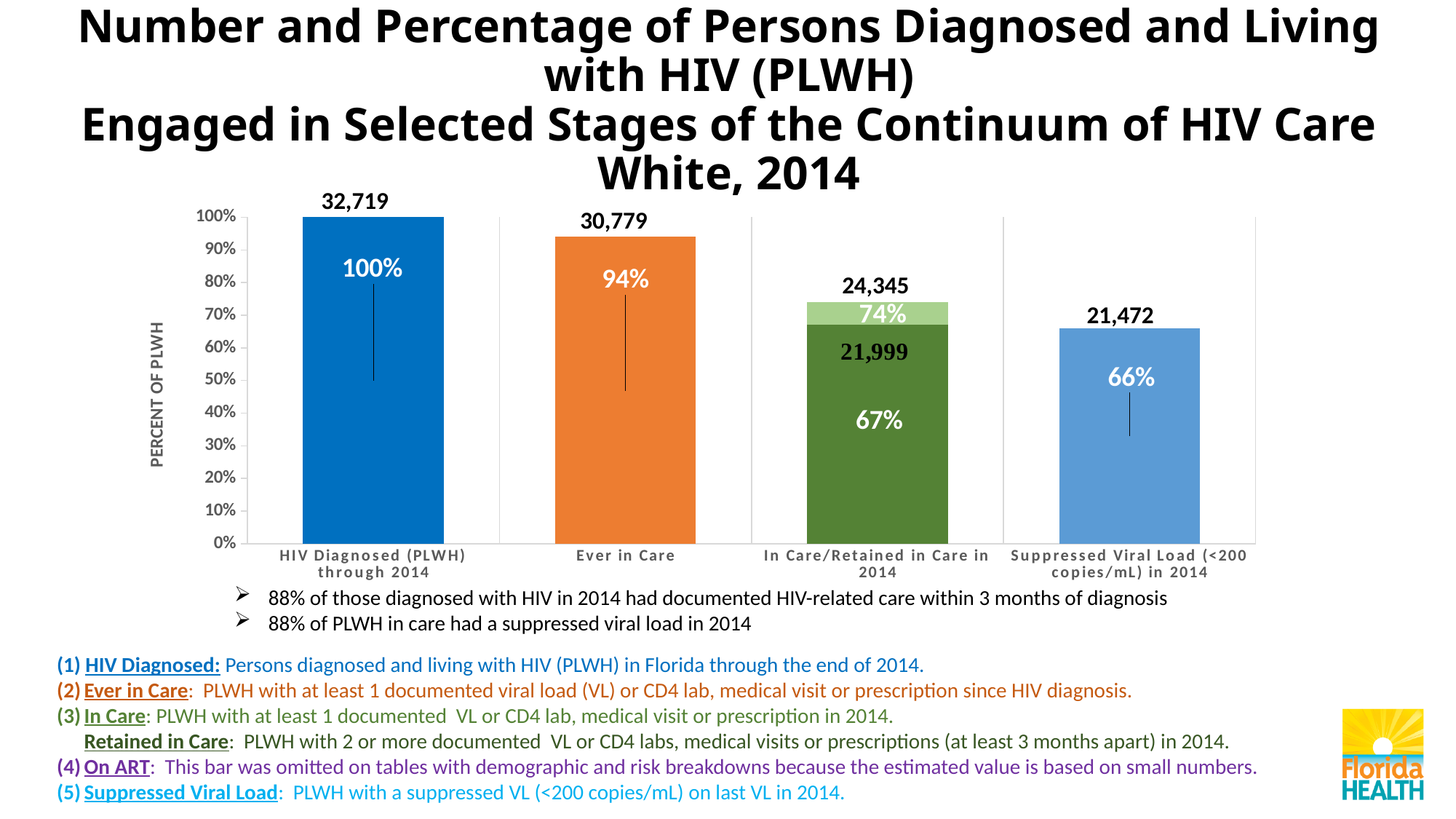
What kind of chart is shown on the slide? Bar chart Which category has the highest percentage of PLWH? HIV Diagnosed (PLWH) through 2014 What number is printed above the Ever in Care bar? 30,779 What number is printed above the bar for HIV Diagnosed (PLWH) through 2014? 32,719 Which category has the lowest percentage of PLWH? Suppressed Viral Load (<200 copies/mL) in 2014 How many categories are shown on the x axis of the chart? 4 What number is printed above the In Care/Retained in Care in 2014 bar? 24,345 What percentage is shown for the darker green Retained in Care portion of the In Care/Retained in Care in 2014 bar? 67% What percentage is shown on the Suppressed Viral Load (<200 copies/mL) in 2014 bar? 66% What percentage is shown on the Ever in Care bar? 94% Which is larger, the percentage for Ever in Care or the percentage for Suppressed Viral Load (<200 copies/mL) in 2014? Ever in Care What is the difference in number of persons between HIV Diagnosed (PLWH) through 2014 and Ever in Care? 1,940